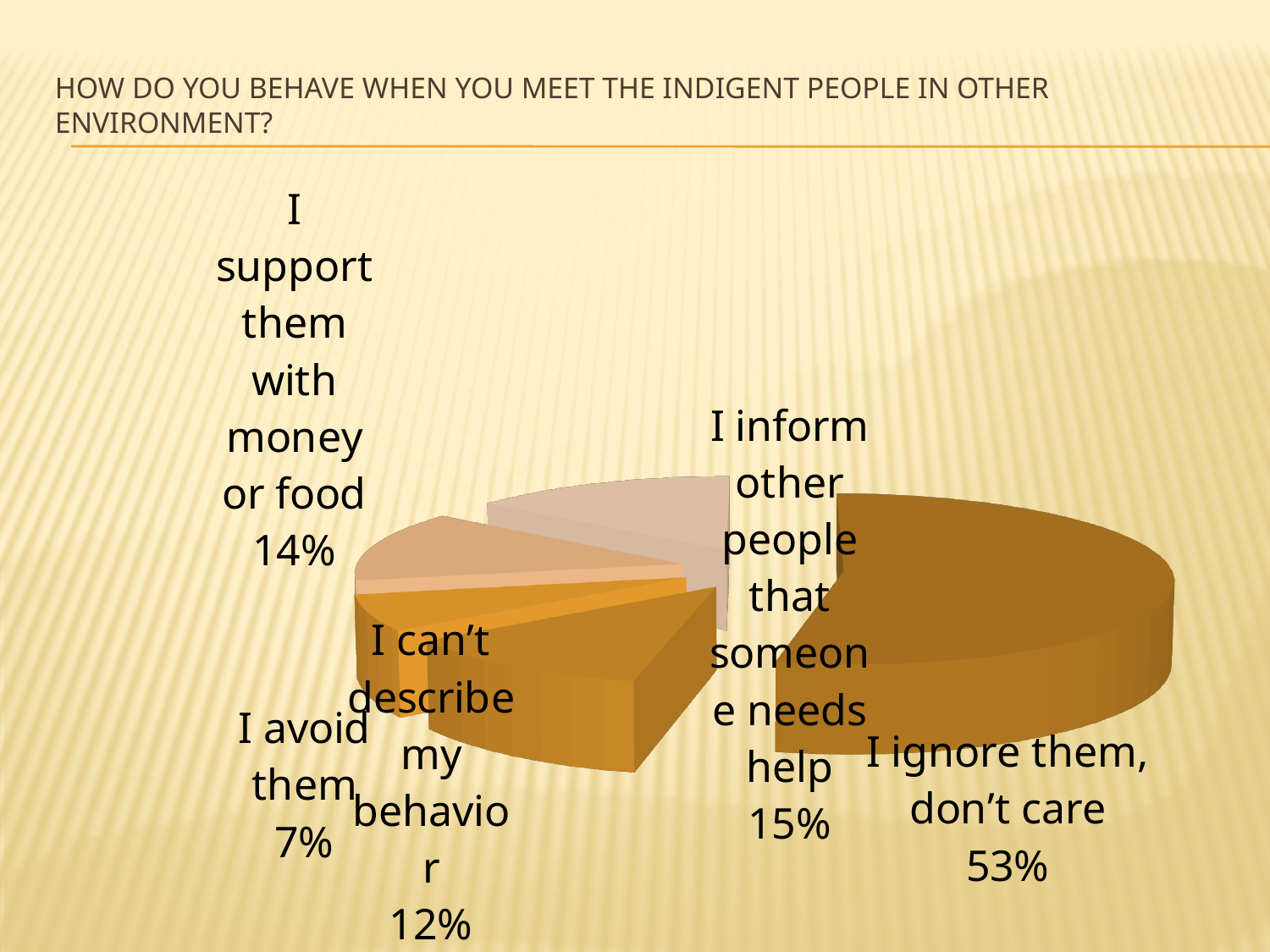
What percentage of respondents answered "I avoid them"? 7% Which response has the largest share of the pie? I ignore them, don't care What percentage of respondents answered "I support them with money or food"? 14% Which is larger: the share for "I support them with money or food" or the share for "I avoid them"? I support them with money or food What kind of chart is shown on the slide? pie chart What percentage of respondents answered "I inform other people that someone needs help"? 15% Which response has the smallest share of the pie? I avoid them What percentage of respondents answered "I can't describe my behavior"? 12% What is the title of the slide containing the pie chart? How do you behave when you meet the indigent people in other environment? How many slices does the pie chart have? 5 What percentage of respondents answered "I ignore them, don't care"? 53% What is the difference in percentage points between "I ignore them, don't care" and "I inform other people that someone needs help"? 38